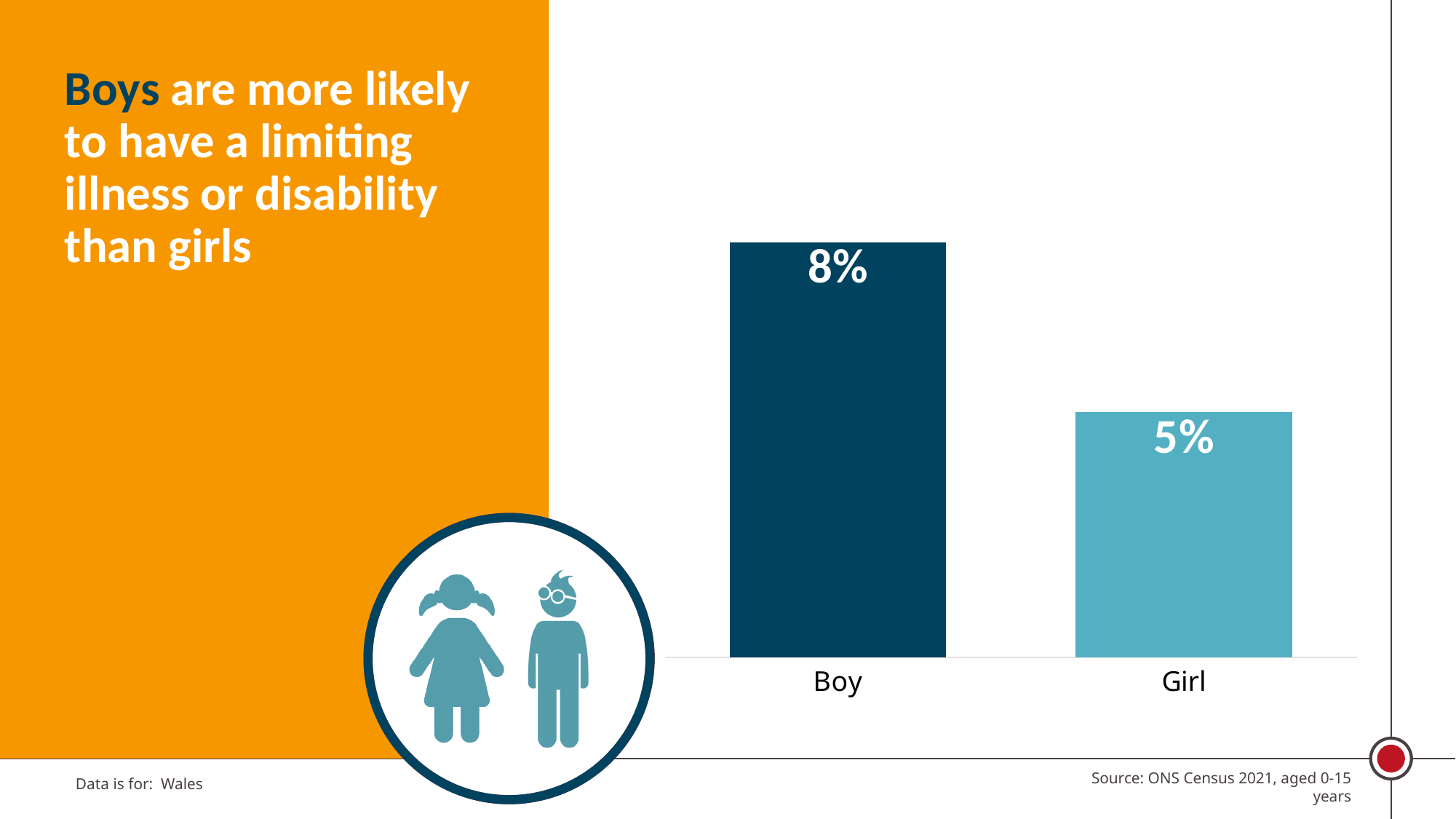
What is the value shown for Girl? 5% Which category has the lowest value? Girl Which category has the highest value? Boy What colour is the bar for Boy? Dark blue According to the slide, which area is the data for? Wales What kind of chart is shown on the slide? Bar chart What is the value shown for Boy? 8% Which is larger, the value for Boy or the value for Girl? Boy How many categories are shown in the chart? 2 What is the difference between the values for Boy and Girl? 3%